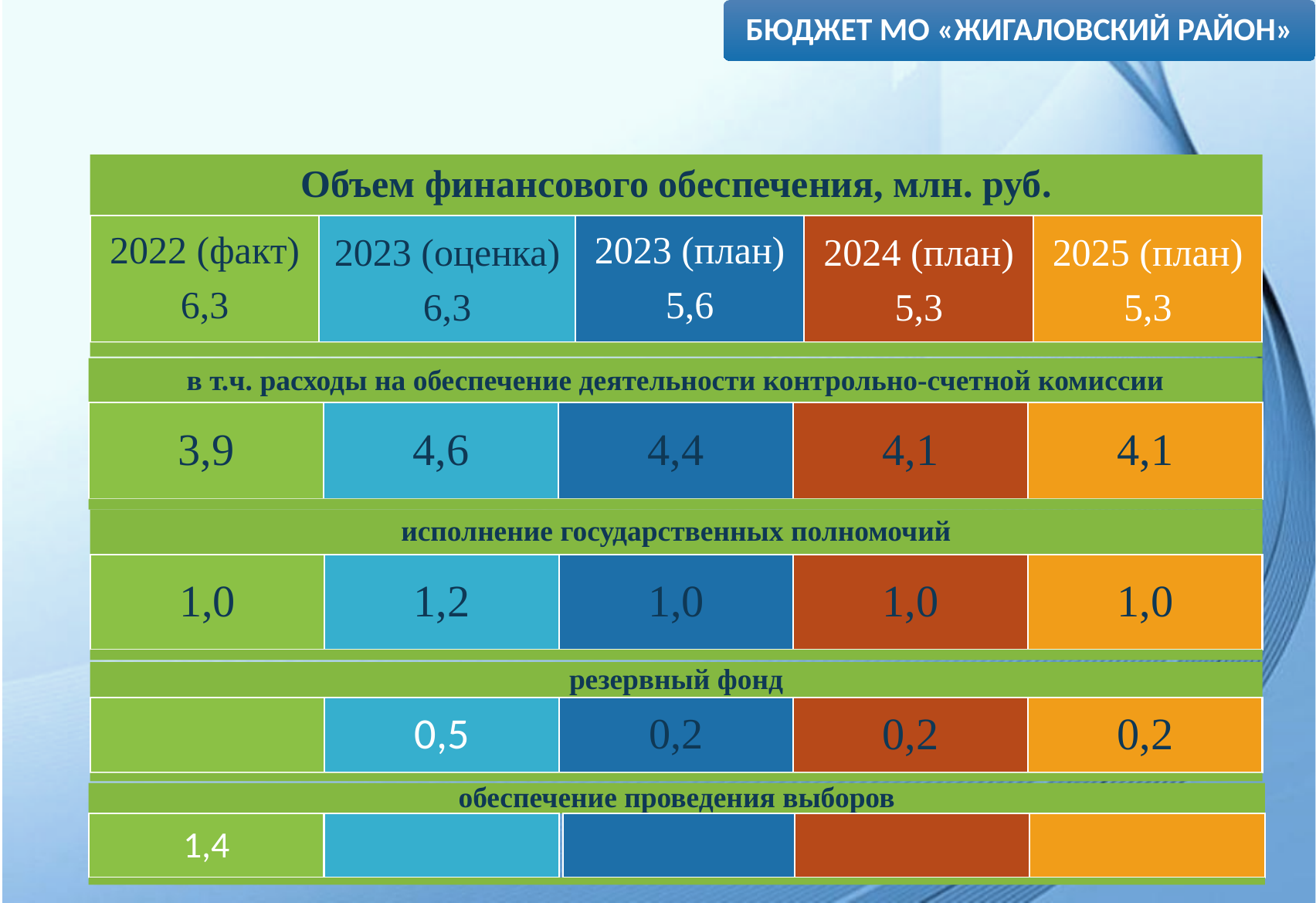
What unit is stated in the title of the table? млн. руб. What is the difference between the total volume of financial support in 2022 (факт) and 2024 (план)? 1,0 Which is larger: 'исполнение государственных полномочий' in 2023 (оценка) or in 2024 (план)? 2023 (оценка) What is the total volume of financial support (Объем финансового обеспечения) for 2022 (факт)? 6,3 What is the total volume of financial support for 2023 (план)? 5,6 What is the value for 'резервный фонд' in 2023 (оценка)? 0,5 What is the value for 'в т.ч. расходы на обеспечение деятельности контрольно-счетной комиссии' in 2023 (оценка)? 4,6 What is the value for 'обеспечение проведения выборов' in 2022 (факт)? 1,4 How many periods (columns) are shown in the table? 5 What is the difference between 'резервный фонд' in 2023 (оценка) and 2023 (план)? 0,3 Which period has the highest value for 'в т.ч. расходы на обеспечение деятельности контрольно-счетной комиссии'? 2023 (оценка) Which period has the lowest value for 'в т.ч. расходы на обеспечение деятельности контрольно-счетной комиссии'? 2022 (факт)